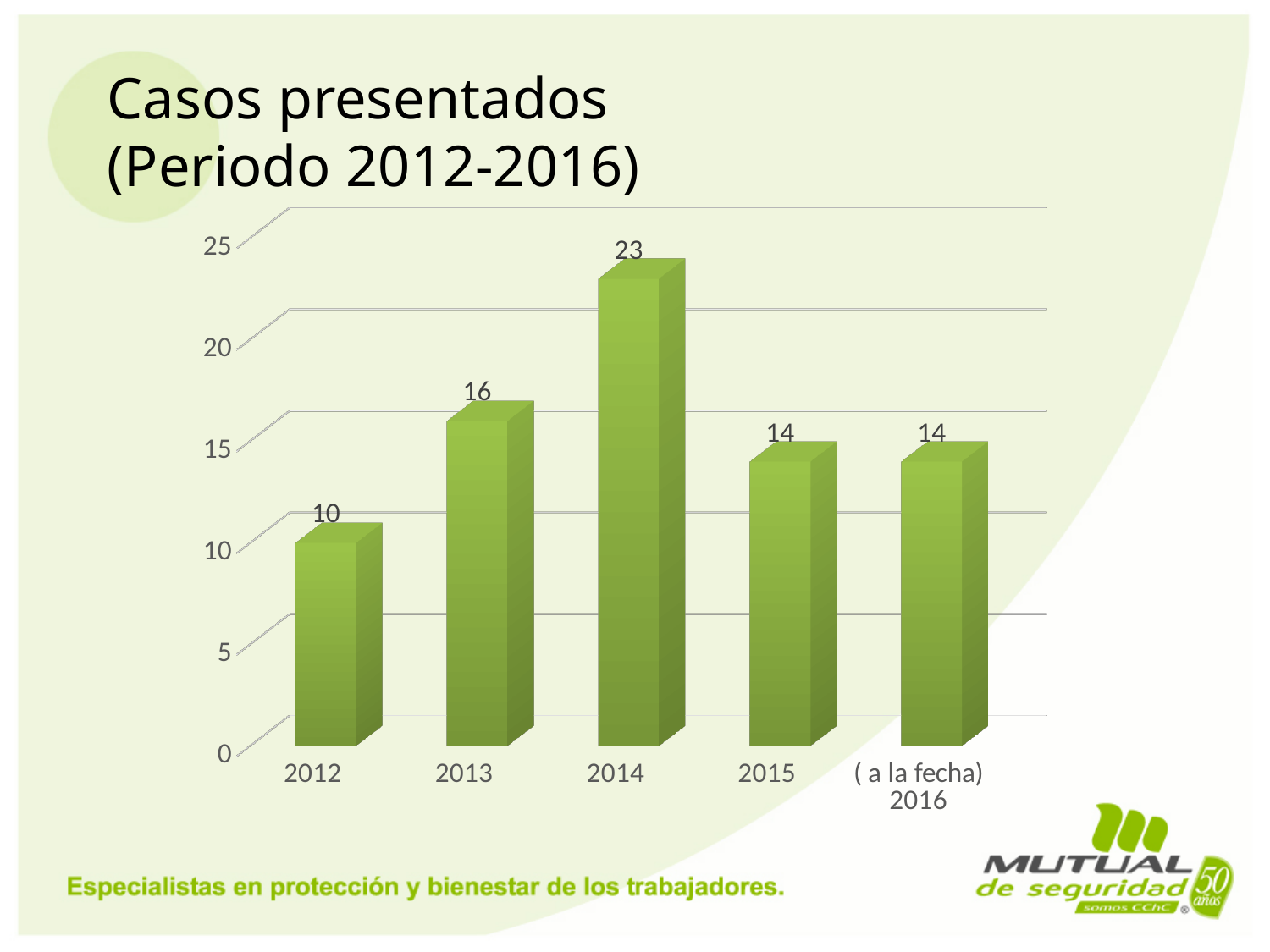
Which year has the highest number of cases presented? 2014 What is the value shown for 2013? 16 What is the difference between the values for 2013 and 2012? 6 What kind of chart is shown on the slide? Bar chart Is the value for 2014 greater or less than 20? greater How many bars are shown in the chart? 5 Which is larger, the value for 2013 or the value for 2015? 2013 What is the title of the chart on the slide? Casos presentados (Periodo 2012-2016) What is the value shown for 2014? 23 How many cases were presented in 2012? 10 Which year has the lowest number of cases presented? 2012 What is the difference between the values for 2014 and 2013? 7